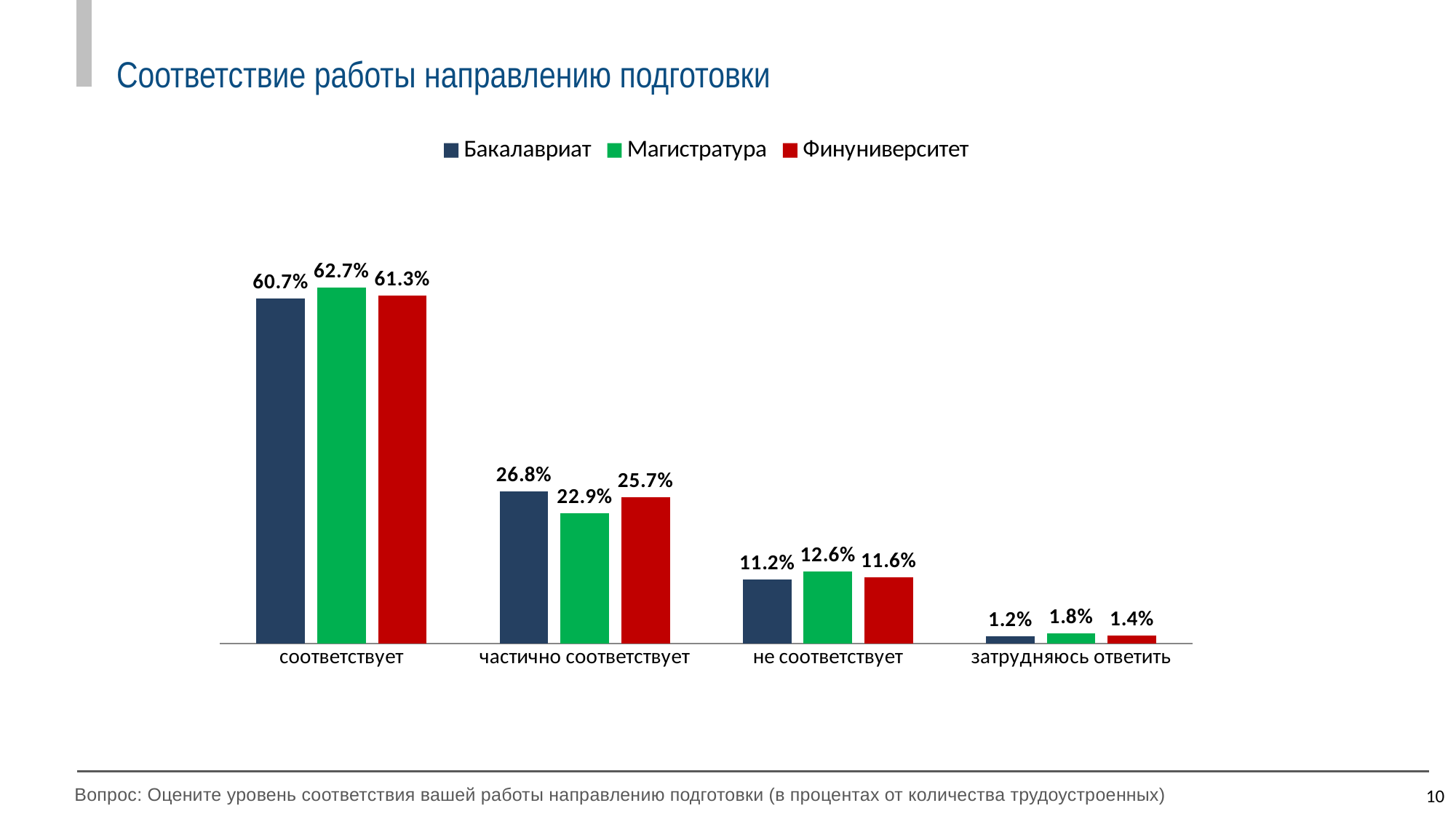
Which category has the highest value for Финуниверситет? соответствует What is the difference between the Бакалавриат and Магистратура values in the category частично соответствует? 3.9% What kind of chart is shown on the slide? Bar chart What is the value for Финуниверситет in the category не соответствует? 11.6% What is the value for Бакалавриат in the category соответствует? 60.7% How many series does the legend list? 3 Which category has the lowest value for Бакалавриат? затрудняюсь ответить How many categories are shown on the x axis? 4 What is the value for Магистратура in the category частично соответствует? 22.9% Do the values for Магистратура rise or fall from left to right along the x axis? Fall What is the value for Магистратура in the category затрудняюсь ответить? 1.8% Which is larger in the category соответствует: the value for Бакалавриат or for Магистратура? Магистратура